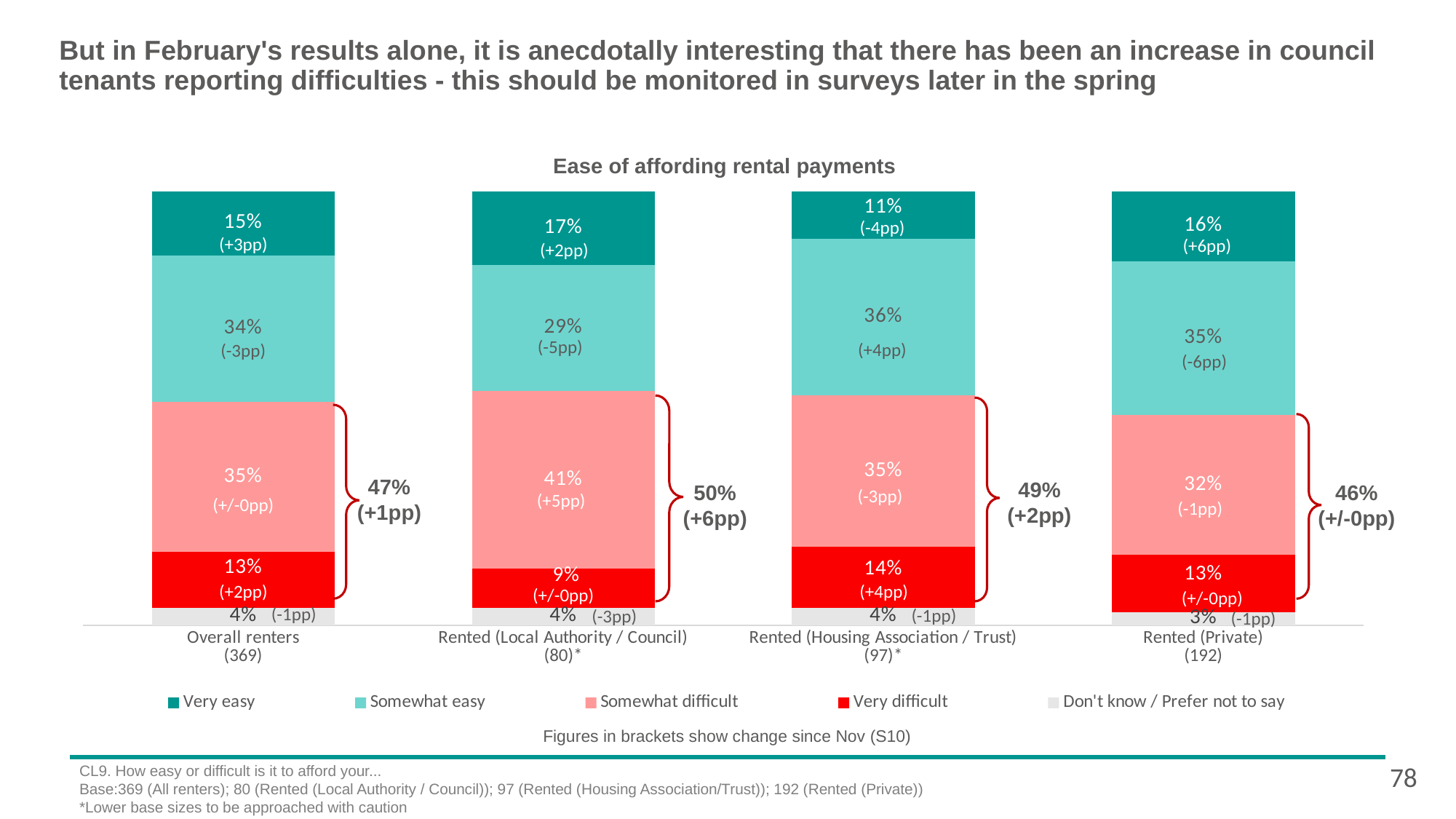
What type of chart is shown on the slide? Stacked bar chart Which renter group has the highest 'Very difficult' percentage? Rented (Housing Association / Trust) How many series does the legend list? 5 What is the title of the chart? Ease of affording rental payments What is the combined 'difficult' percentage shown in the bracket for Rented (Private)? 46% How many categories (renter groups) are shown on the x axis? 4 Which renter group has the lowest 'Very easy' percentage? Rented (Housing Association / Trust) Which is larger: the 'Somewhat easy' percentage for Overall renters or for Rented (Local Authority / Council)? Overall renters What percentage of Rented (Local Authority / Council) renters said it was somewhat difficult? 41% What percentage of Rented (Housing Association / Trust) renters said it was very easy? 11% What is the difference in the 'Somewhat difficult' percentage between Rented (Local Authority / Council) and Rented (Private)? 9 percentage points What change since Nov is shown in brackets for the 'Very easy' segment of Rented (Private)? +6pp